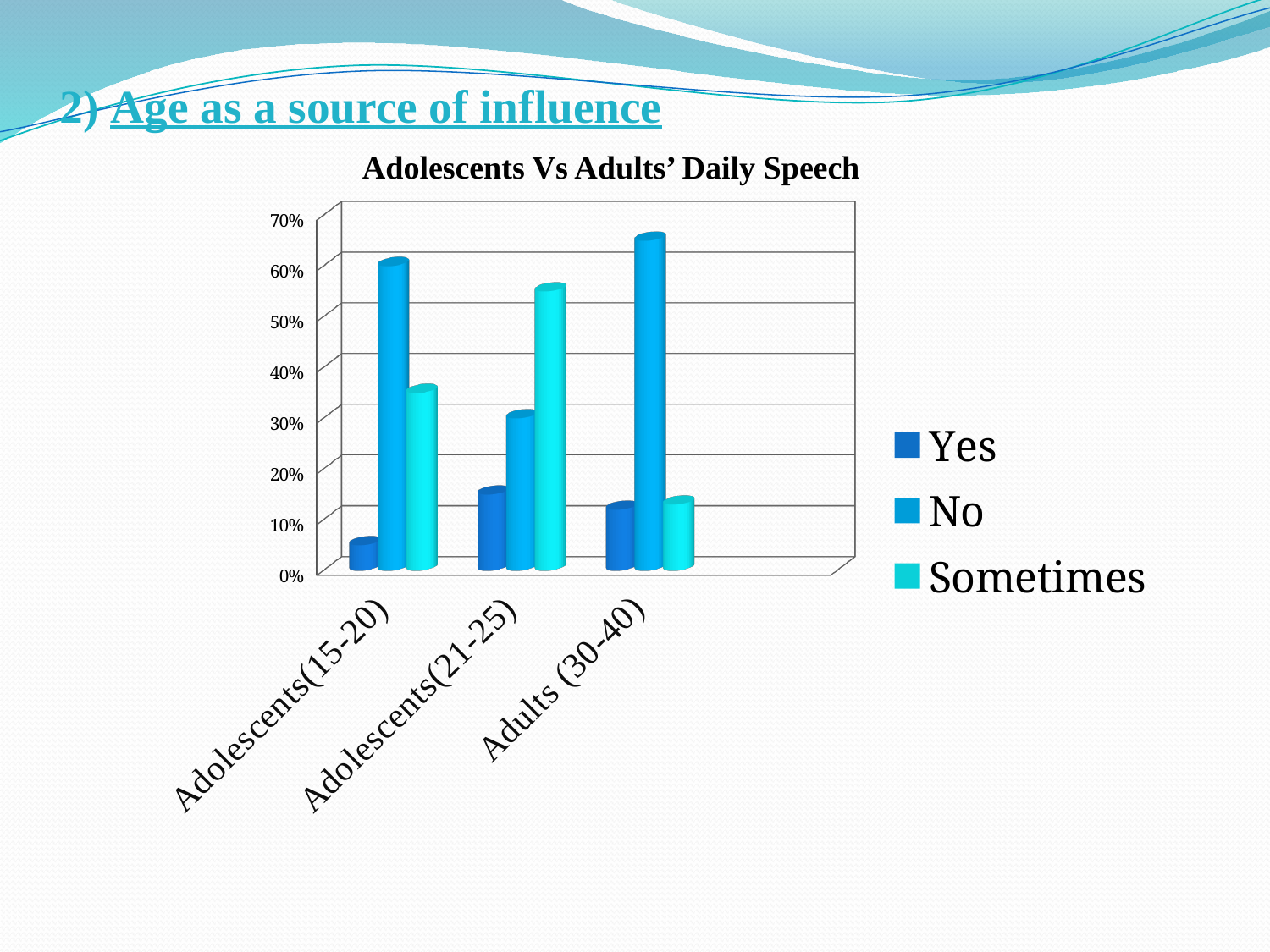
Which series has the lowest value for Adolescents(15-20)? Yes How many series does the legend list? 3 Is the 'Sometimes' value for Adolescents(21-25) greater or less than 50%? greater Which is larger: the 'No' value for Adolescents(15-20) or the 'No' value for Adolescents(21-25)? Adolescents(15-20) What is the title of the chart? Adolescents Vs Adults' Daily Speech Is the 'No' value for Adults (30-40) greater or less than 60%? greater Is the 'Yes' value for Adolescents(15-20) greater or less than 10%? less Which category has the highest 'No' value? Adults (30-40) What kind of chart is shown on the slide? Bar chart How many age-group categories are shown on the x axis? 3